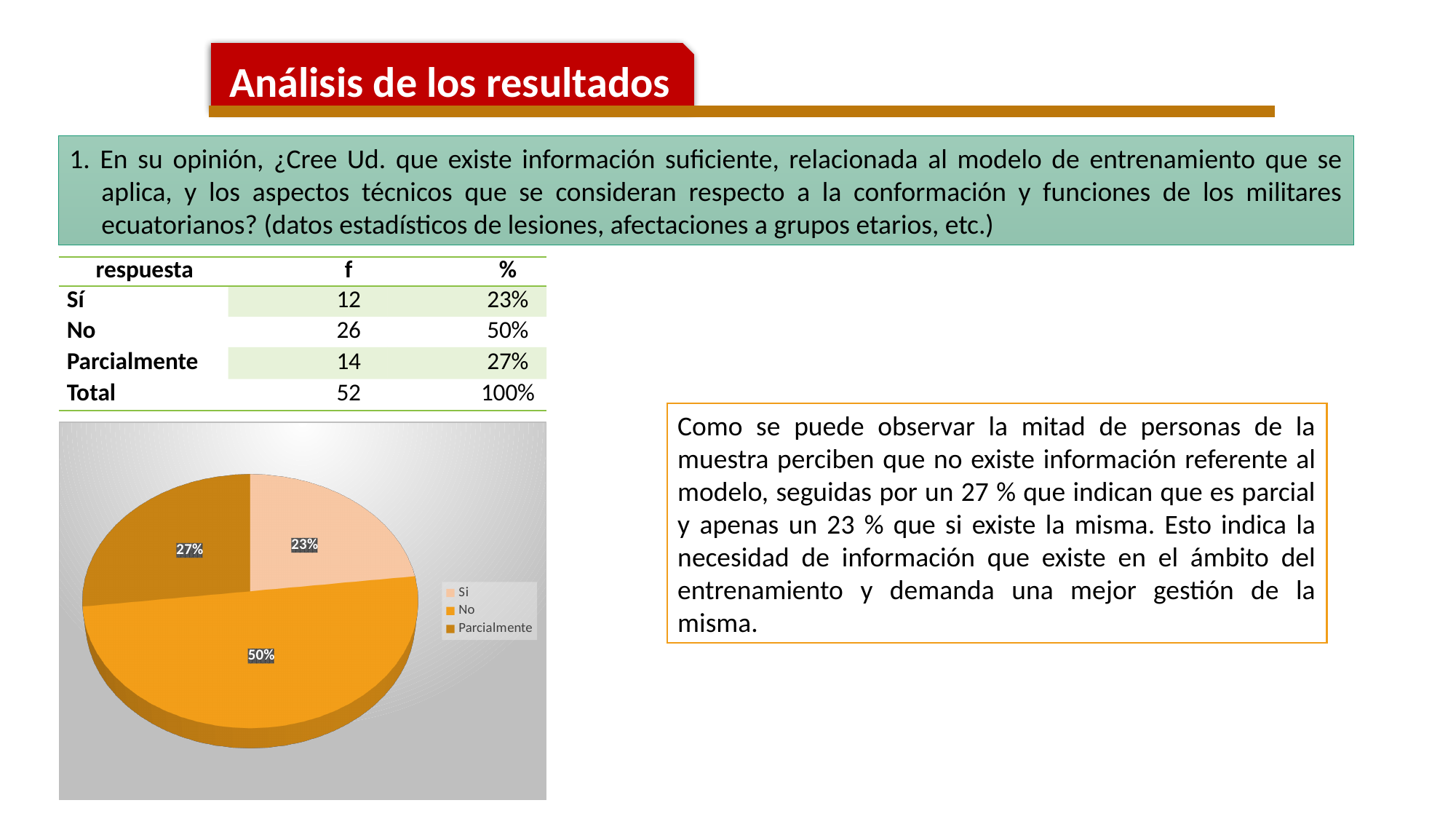
How many entries does the legend list? 3 Which category has the largest slice of the pie? No What share of the pie does the "Si" slice represent? 23% What is the difference in percentage points between the "Parcialmente" slice and the "Si" slice? 4 Which legend entry is shown in the lightest colour? Si Which slice is larger, "Si" or "Parcialmente"? Parcialmente How many slices does the pie chart have? 3 What is the difference in percentage points between the "No" slice and the "Parcialmente" slice? 23 What share of the pie does the "No" slice represent? 50% What kind of chart is shown on the slide? Pie chart What share of the pie does the "Parcialmente" slice represent? 27% Which category has the smallest slice of the pie? Si